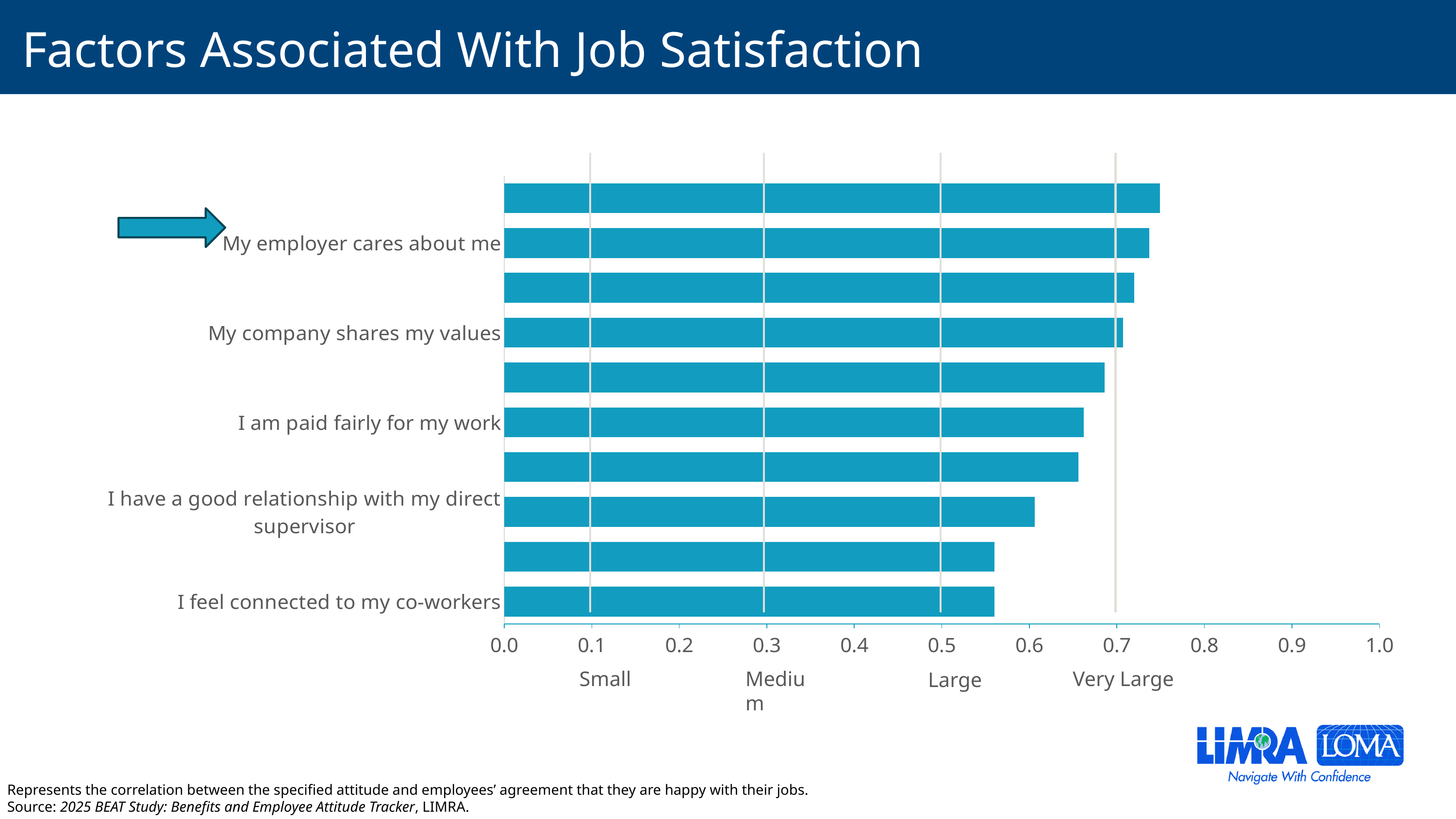
Is the value for "I feel connected to my co-workers" greater or less than 0.6? less Is the value for "My company shares my values" greater or less than 0.6? greater How many bars are plotted in the chart? 10 Which has the larger value: "My employer cares about me" or "I feel connected to my co-workers"? My employer cares about me What is the title of the chart on the slide? Factors Associated With Job Satisfaction Is the value for "I am paid fairly for my work" greater or less than 0.7? less Which has the larger value: "I am paid fairly for my work" or "I feel connected to my co-workers"? I am paid fairly for my work What kind of chart is shown on the slide? bar chart Of the labeled factors, which has the lowest value? I feel connected to my co-workers